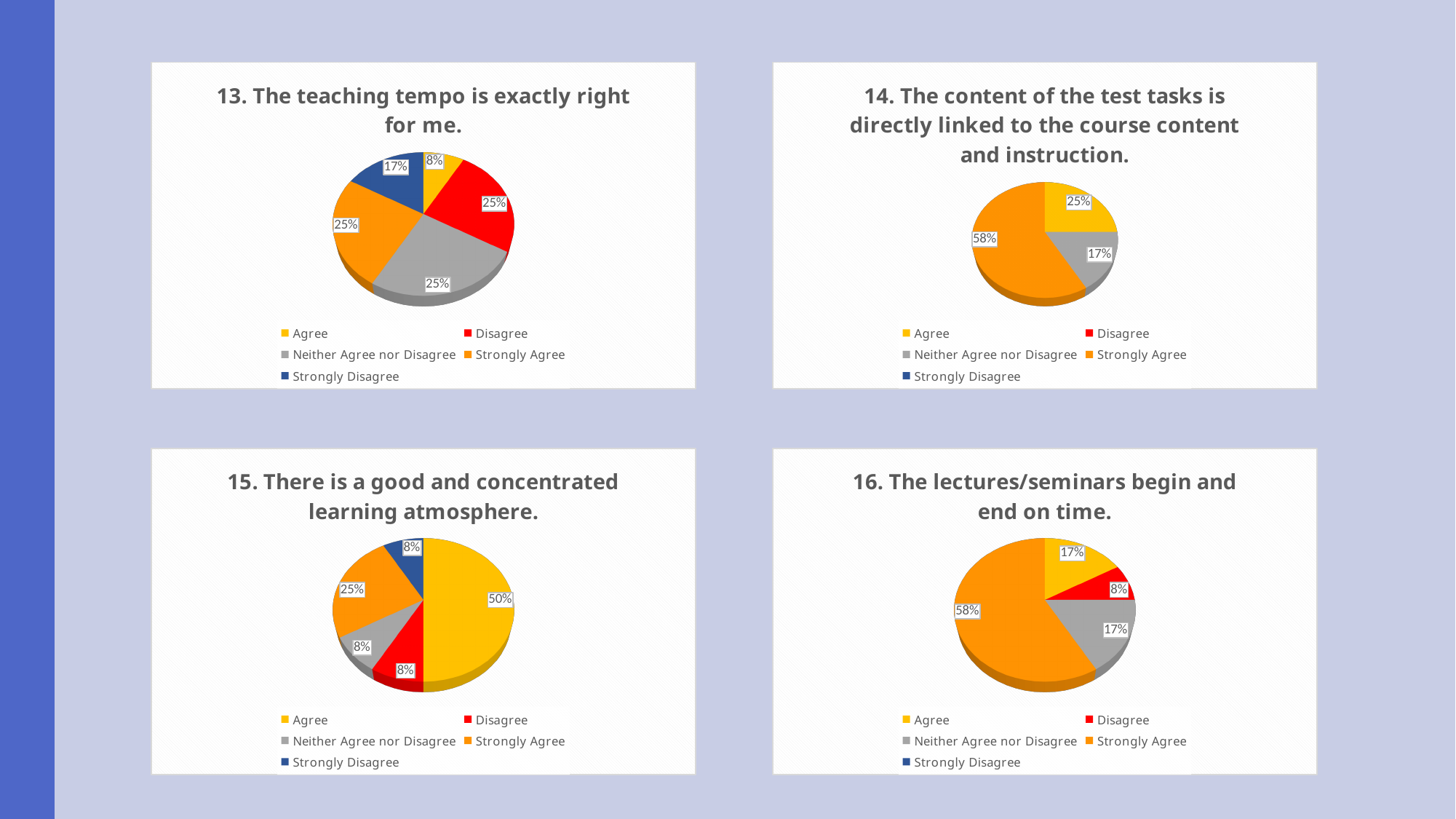
In the chart titled "13. The teaching tempo is exactly right for me.", what is the value for Agree? 8% In the chart titled "16. The lectures/seminars begin and end on time.", how many slices are shown in the pie? 4 In the chart titled "16. The lectures/seminars begin and end on time.", what is the value for Strongly Agree? 58% In the chart titled "15. There is a good and concentrated learning atmosphere.", which is larger, Strongly Agree or Disagree? Strongly Agree In the chart titled "13. The teaching tempo is exactly right for me.", what share of the pie is Strongly Disagree? 17% What kind of chart is used in the chart titled "13. The teaching tempo is exactly right for me."? Pie chart In the chart titled "14. The content of the test tasks is directly linked to the course content and instruction.", what is the difference between Strongly Agree and Agree? 33% In the chart titled "14. The content of the test tasks is directly linked to the course content and instruction.", which category has the largest slice? Strongly Agree In the chart titled "15. There is a good and concentrated learning atmosphere.", what is the value for Agree? 50% In the chart titled "16. The lectures/seminars begin and end on time.", which category has the smallest slice? Disagree In the chart titled "14. The content of the test tasks is directly linked to the course content and instruction.", what is the value for Neither Agree nor Disagree? 17% How many entries does the legend list in the chart titled "15. There is a good and concentrated learning atmosphere."? 5